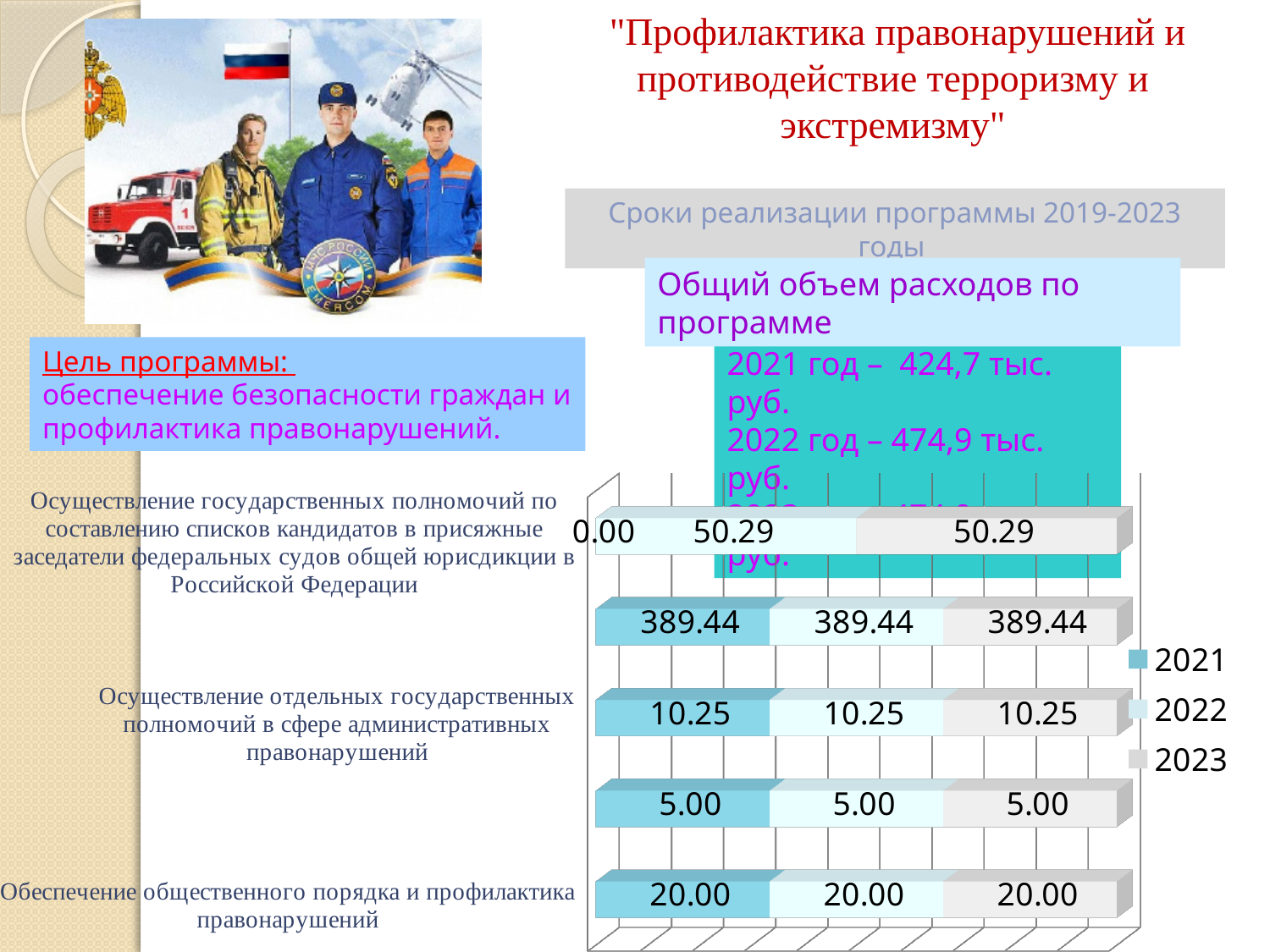
What is the 2021 value for 'Обеспечение общественного порядка и профилактика правонарушений'? 20.00 How many bars (categories) are plotted in the chart? 5 What is the difference between the 2022 and 2021 values for the top bar (Осуществление государственных полномочий по составлению списков кандидатов в присяжные заседатели)? 50.29 What kind of chart is shown on the slide? bar chart What is the largest single value labelled in the chart? 389.44 What is the 2023 value for 'Осуществление отдельных государственных полномочий в сфере административных правонарушений'? 10.25 What is the 2022 value for the top bar (Осуществление государственных полномочий по составлению списков кандидатов в присяжные заседатели)? 50.29 What is the total of the three stacked segments in the bottom bar (Обеспечение общественного порядка и профилактика правонарушений)? 60.00 Which has the larger 2021 value: 'Обеспечение общественного порядка и профилактика правонарушений' or 'Осуществление отдельных государственных полномочий в сфере административных правонарушений'? Обеспечение общественного порядка и профилактика правонарушений What is the 2021 value for the top bar (Осуществление государственных полномочий по составлению списков кандидатов в присяжные заседатели)? 0.00 What are the legend entries of the chart? 2021, 2022, 2023 How many series does the chart legend list? 3